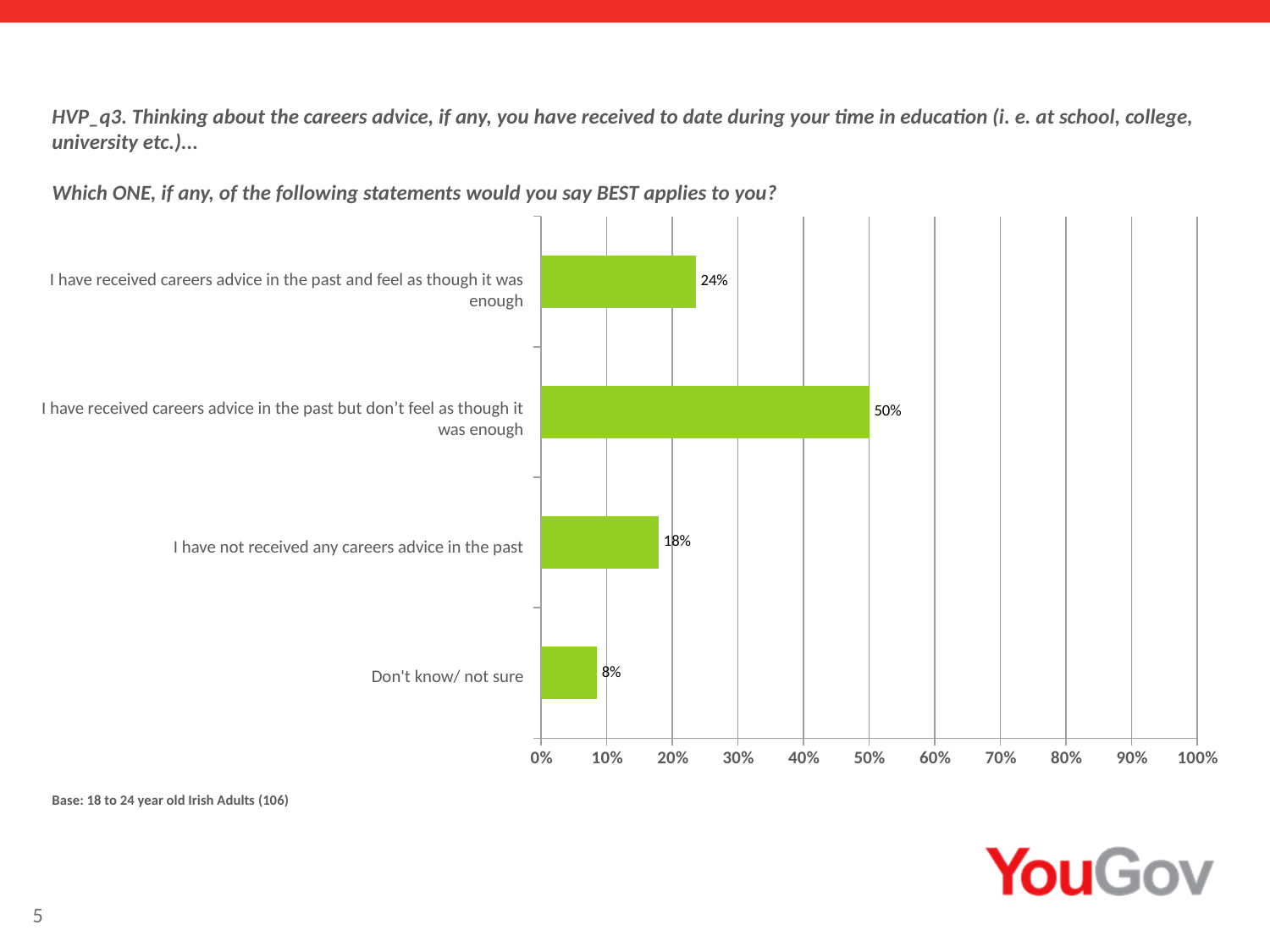
What percentage of respondents said they have received careers advice in the past and feel as though it was enough? 24% What is the base described below the chart? 18 to 24 year old Irish Adults (106) What type of chart is shown on the slide? Bar chart Is the value for 'I have received careers advice in the past and feel as though it was enough' greater or less than 30%? less What is the difference in percentage points between those who received advice but don't feel it was enough and those who received advice and feel it was enough? 26 Which response option has the lowest percentage? Don't know/ not sure How many response categories are shown in the chart? 4 What percentage of respondents said they have received careers advice in the past but don't feel as though it was enough? 50% Which is larger: the percentage who have not received any careers advice, or the percentage who answered 'Don't know/ not sure'? I have not received any careers advice in the past Which statement has the highest percentage of respondents? I have received careers advice in the past but don't feel as though it was enough What percentage of respondents said they have not received any careers advice in the past? 18% What percentage of respondents answered 'Don't know/ not sure'? 8%